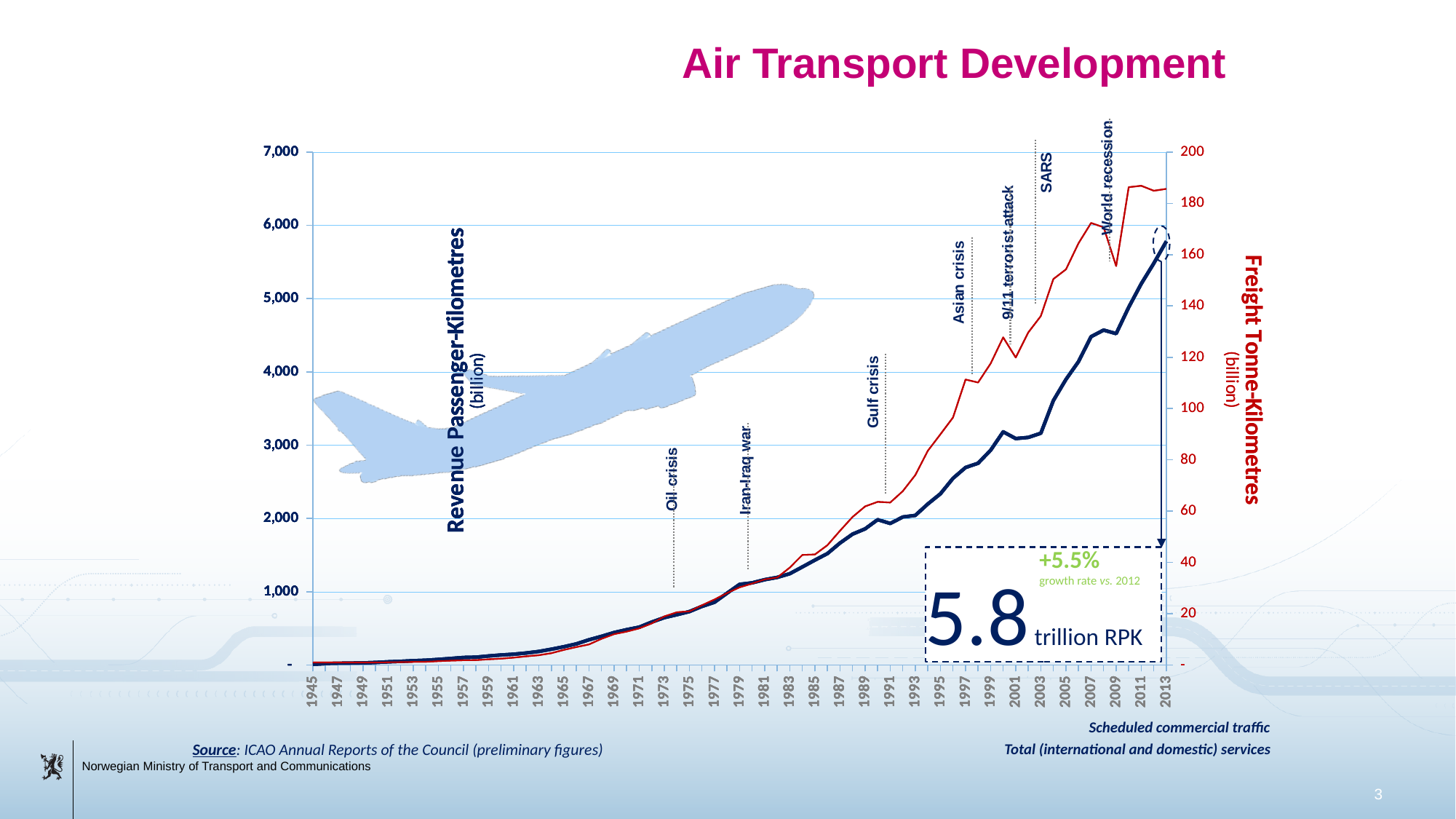
How many crisis events are annotated along the chart? 7 What is the title of the slide? Air Transport Development Is the Revenue Passenger-Kilometres value for 1985 greater or less than 2,000 billion? less In which year does the Revenue Passenger-Kilometres line reach its highest value? 2013 Is the Revenue Passenger-Kilometres value for 2013 greater or less than 5,000 billion? greater What kind of chart is shown on the slide? line chart Is the Freight Tonne-Kilometres value for 2013 greater or less than 160 billion? greater According to the callout box, what was the Revenue Passenger-Kilometres figure for 2013? 5.8 trillion RPK What colour is the Freight Tonne-Kilometres line? red What growth rate vs. 2012 is shown in the callout box? +5.5% Do the Revenue Passenger-Kilometres values rise or fall from 1945 to 2013? rise